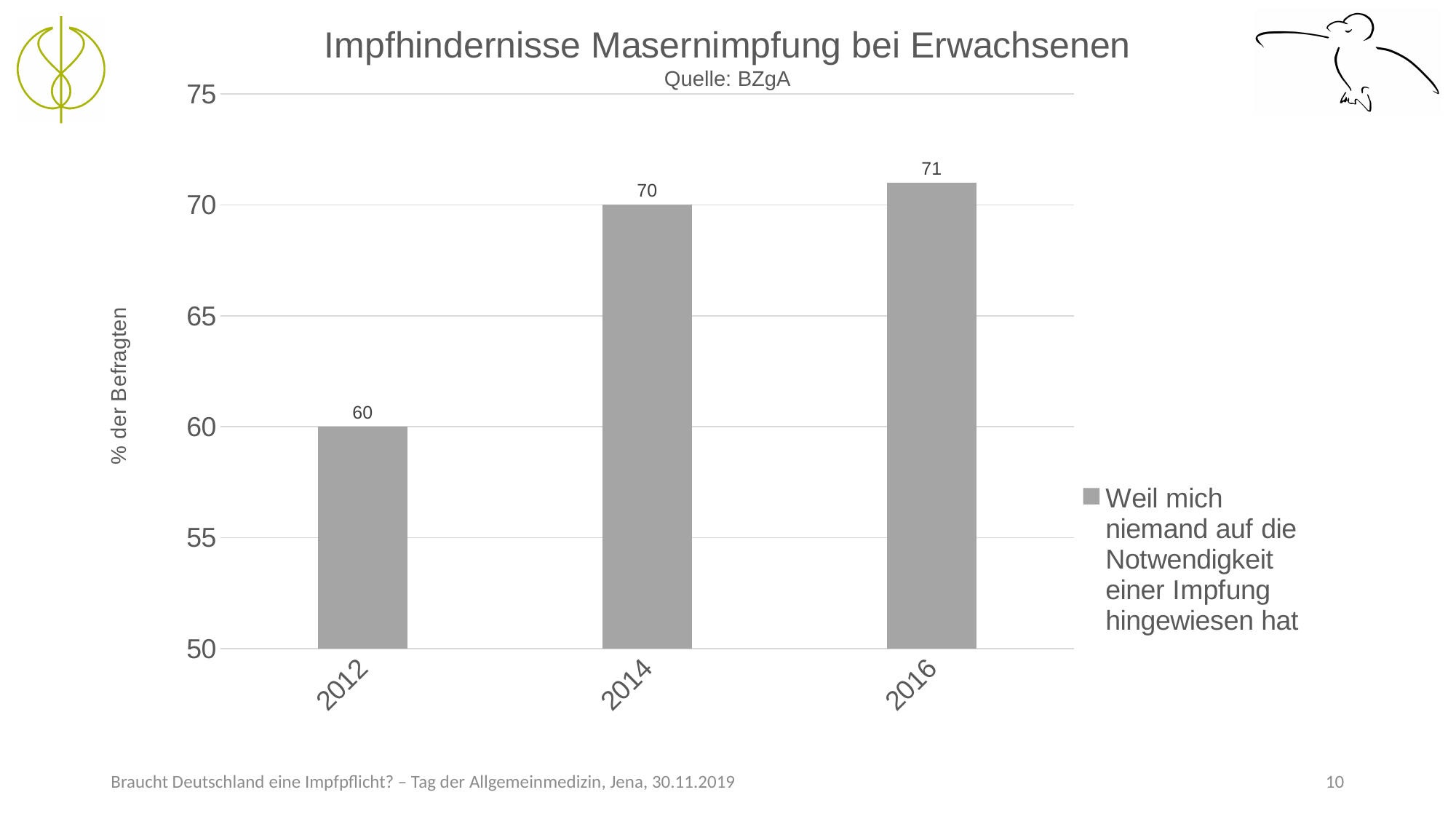
How many years are shown on the x axis? 3 What is the value for 2016? 71 Is the value for 2016 greater or less than 65? greater Which year has the lowest value? 2012 How many series does the legend list? 1 Which is larger, the value for 2012 or the value for 2014? 2014 What kind of chart is shown? bar chart Which year has the highest value? 2016 What is the value for 2012? 60 Do the values rise or fall from 2012 to 2016? rise What is the value for 2014? 70 What is the difference between the values for 2014 and 2012? 10